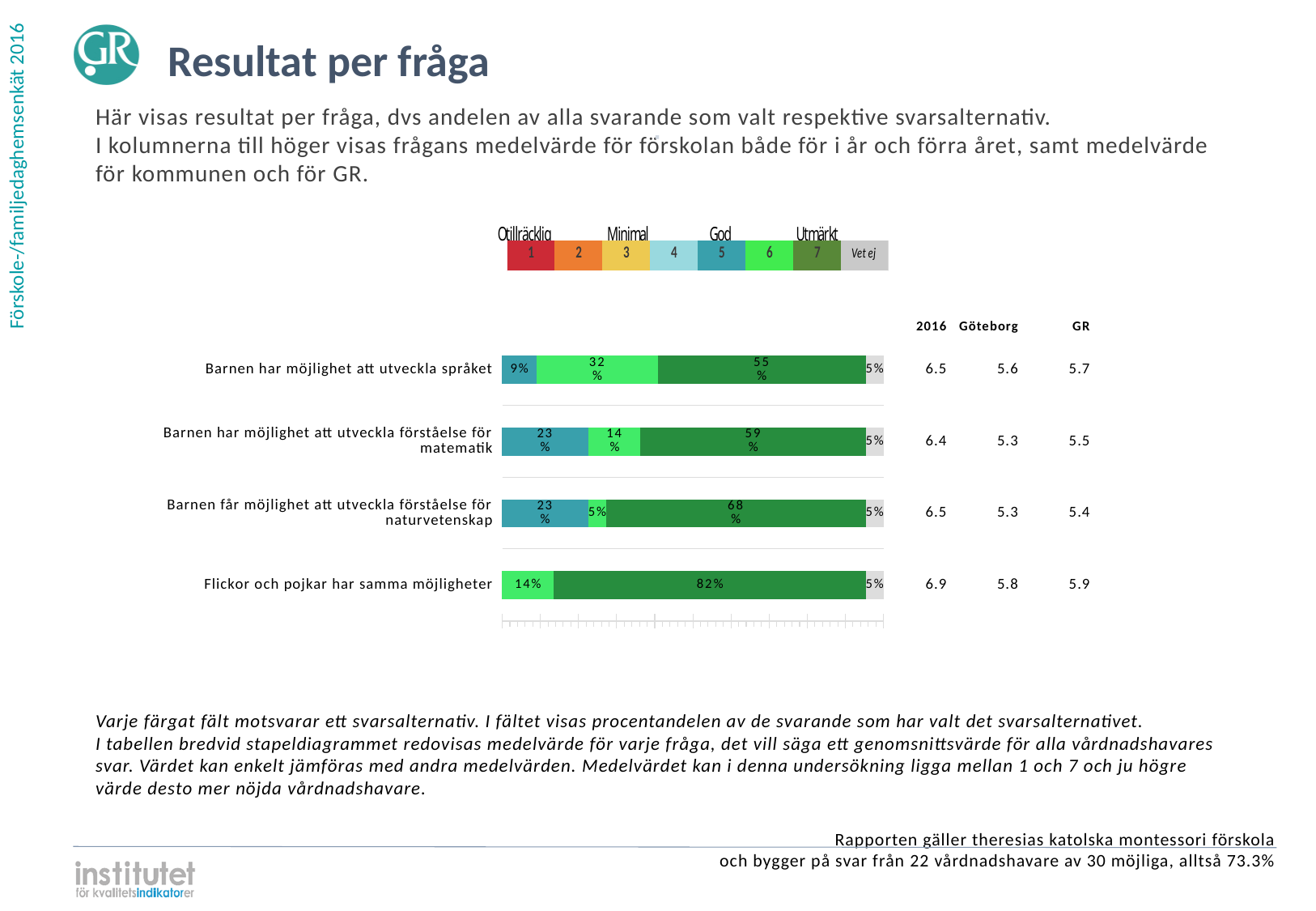
Which has a larger share of answer 6 (light green): 'Barnen har möjlighet att utveckla språket' or 'Barnen har möjlighet att utveckla förståelse för matematik'? Barnen har möjlighet att utveckla språket What kind of chart is shown on the slide? stacked bar chart What percentage of respondents chose answer 7 (dark green) for 'Flickor och pojkar har samma möjligheter'? 82% How many questions (categories) are plotted in the bar chart? 4 What label does the legend give to answer alternative 7? Utmärkt What percentage of respondents chose answer 7 (dark green) for 'Barnen har möjlighet att utveckla språket'? 55% What percentage of respondents chose answer 5 (teal) for 'Barnen har möjlighet att utveckla förståelse för matematik'? 23% What percentage of respondents chose answer 6 (light green) for 'Barnen får möjlighet att utveckla förståelse för naturvetenskap'? 5% Which question has the largest share of respondents choosing answer 7 (dark green)? Flickor och pojkar har samma möjligheter Which question has the smallest share of respondents choosing answer 7 (dark green)? Barnen har möjlighet att utveckla språket What is the difference in percentage points between the answer 7 share for 'Flickor och pojkar har samma möjligheter' (82%) and for 'Barnen har möjlighet att utveckla språket' (55%)? 27 percentage points How many answer alternatives does the legend above the chart list? 8